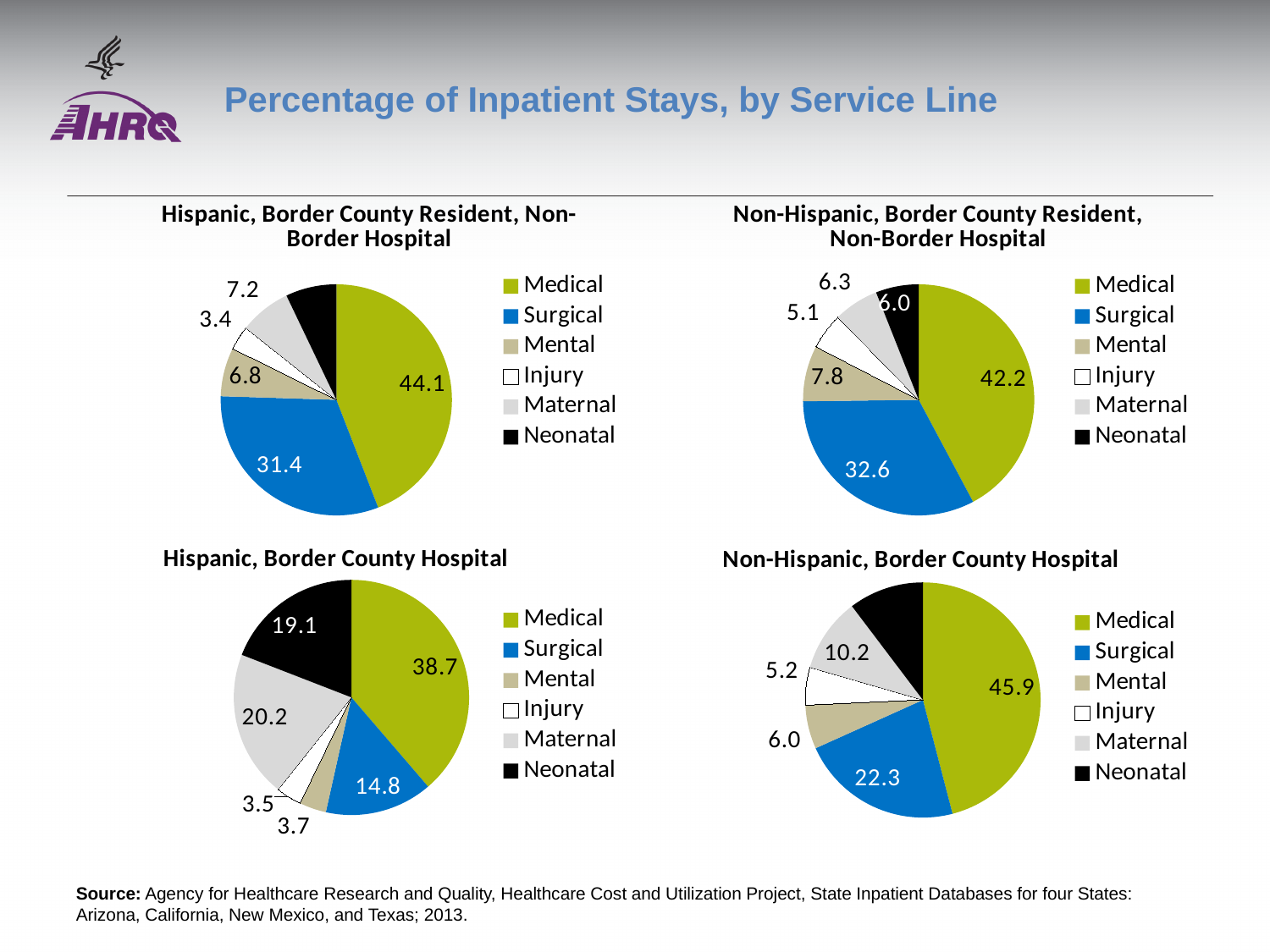
How many service lines does the legend of the 'Hispanic, Border County Hospital' chart list? 6 In the 'Hispanic, Border County Resident, Non-Border Hospital' chart, what is the difference between the Medical and Surgical values? 12.7 In the 'Hispanic, Border County Resident, Non-Border Hospital' chart, what percentage of inpatient stays is Medical? 44.1 In the 'Non-Hispanic, Border County Hospital' chart, what is the difference between the Surgical and Maternal values? 12.1 In the 'Non-Hispanic, Border County Resident, Non-Border Hospital' chart, what is the value for Surgical? 32.6 In the 'Hispanic, Border County Hospital' chart, which service line has the largest share? Medical In the 'Non-Hispanic, Border County Hospital' chart, what is the value for Injury? 5.2 In the 'Hispanic, Border County Hospital' chart, what is the value for Maternal? 20.2 How many pie charts are shown on the slide? 4 In the 'Hispanic, Border County Hospital' chart, which is larger, Maternal or Neonatal? Maternal What type of chart is the 'Non-Hispanic, Border County Hospital' chart? Pie chart In the 'Non-Hispanic, Border County Resident, Non-Border Hospital' chart, which service line has the smallest share? Injury